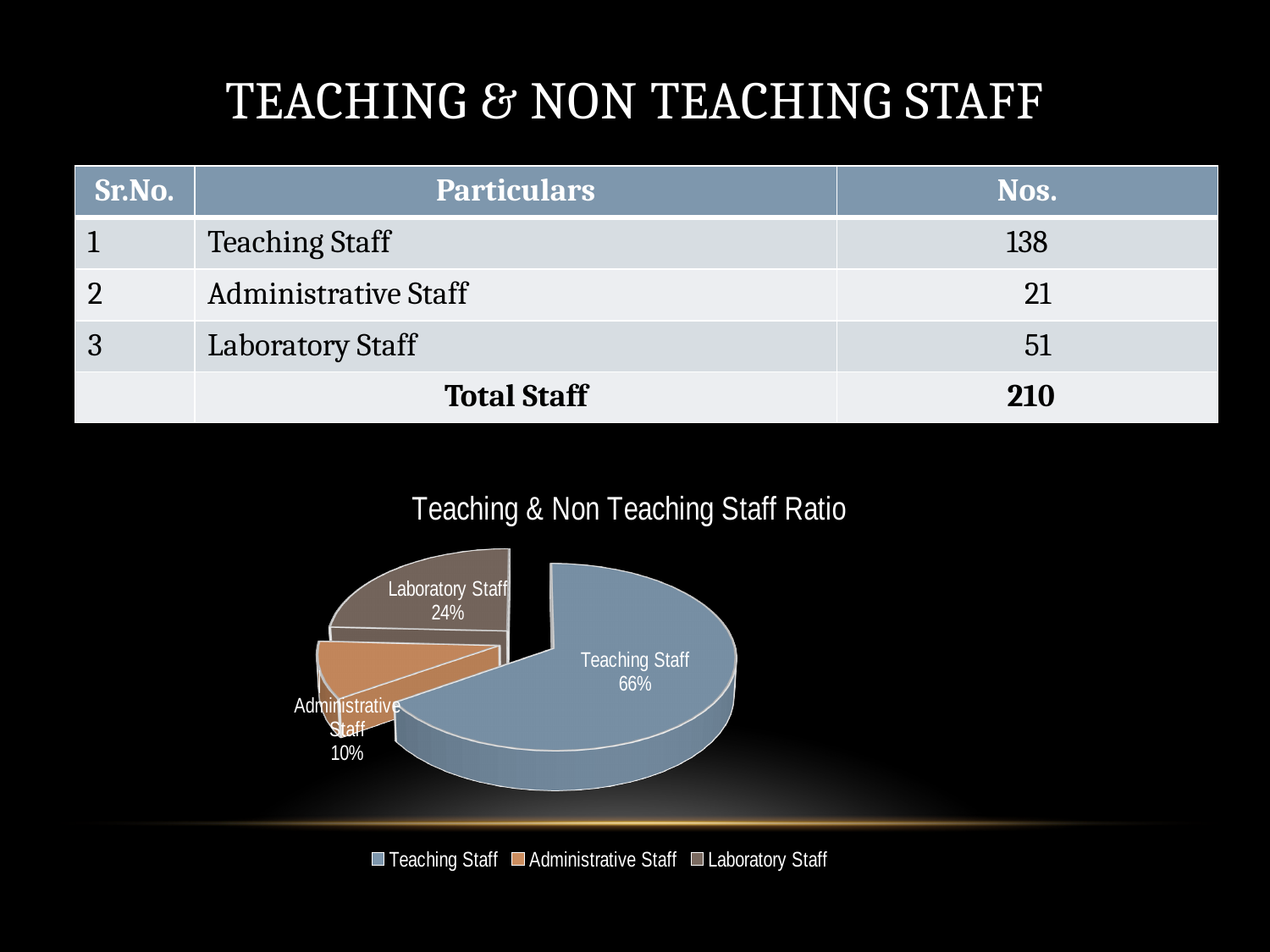
What percentage of the pie does Laboratory Staff represent? 24% What percentage of the pie does Administrative Staff represent? 10% Which category has the largest slice of the pie? Teaching Staff How many entries does the legend list? 3 What is the title of the chart? Teaching & Non Teaching Staff Ratio What type of chart is shown on the slide? pie chart Which slice is larger, Laboratory Staff or Administrative Staff? Laboratory Staff How many slices does the pie chart have? 3 What percentage of the pie does Teaching Staff represent? 66% Which category has the smallest slice of the pie? Administrative Staff What is the difference in percentage points between the Teaching Staff slice and the Laboratory Staff slice? 42 Which legend entry is shown in orange? Administrative Staff